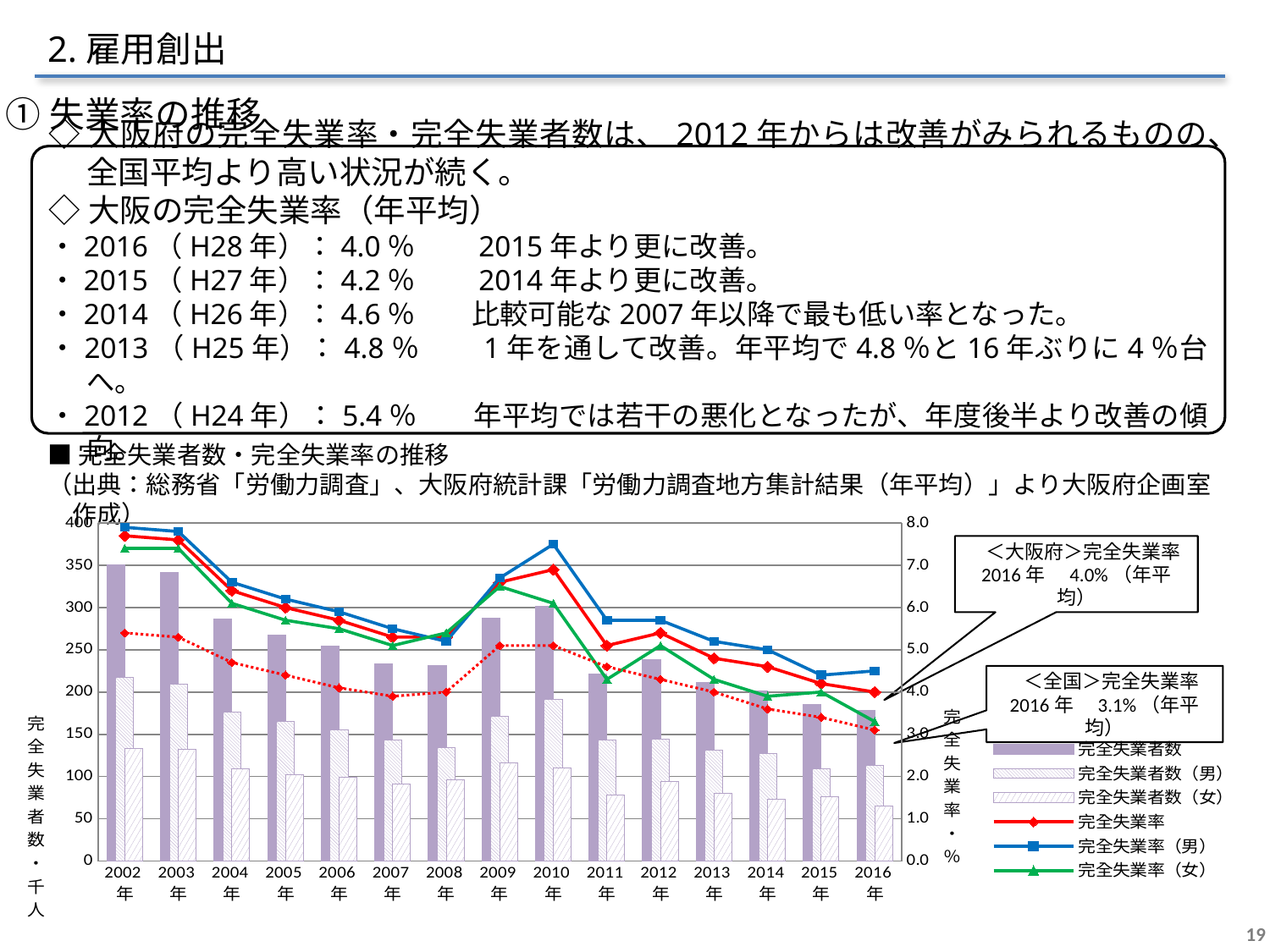
In which year is the 完全失業率 line (red) highest? 2002年 In 2016年, which is larger: 完全失業率（男） or 完全失業率（女）? 完全失業率（男） Does the 完全失業率 line rise or fall from 2010年 to 2016年? It falls Is the 完全失業率（男） value for 2010年 greater or less than 7.0? greater How many series does the chart legend list? 6 Is the 完全失業者数 value for 2008年 greater or less than 250? less According to the callout on the chart, what was the 全国 完全失業率 in 2016年? 3.1% What kind of chart is shown on the slide? A combined bar and line chart In which year is the 完全失業者数 bar lowest? 2016年 According to the callout on the chart, what was the 完全失業率 for 大阪府 in 2016年? 4.0% What is the difference between the 大阪府 完全失業率 (4.0%) and the 全国 完全失業率 (3.1%) in 2016年 shown in the callouts? 0.9 percentage points How many years are shown on the x axis of the chart? 15